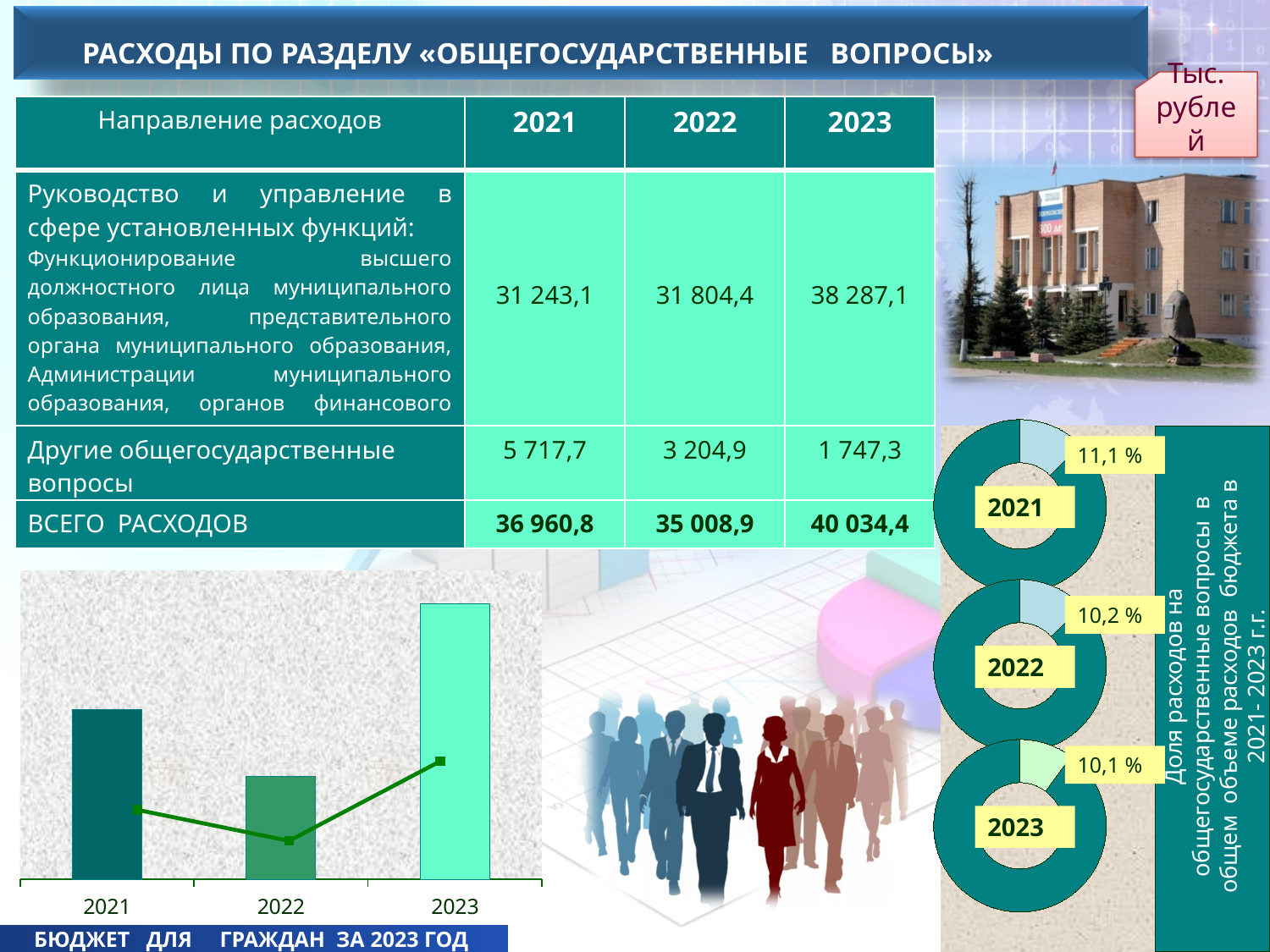
What kind of chart is shown in the bottom-left of the slide? bar chart In the bottom-left bar chart, do the bars rise or fall from 2022 to 2023? rise How many categories are shown on the x axis of the bottom-left bar chart? 3 In the bottom-left bar chart, which year has the shortest bar? 2022 In the bottom-left bar chart, which year has the tallest bar? 2023 In the bottom-left bar chart, is the bar for 2021 taller or shorter than the bar for 2022? taller In the donut charts on the right, what share is shown for 2023? 10,1 % In the donut charts on the right, what is the difference between the share for 2021 and the share for 2022? 0,9 % In the donut charts on the right, what share is shown for 2021? 11,1 % In the donut charts on the right, what share is shown for 2022? 10,2 % Among the donut charts on the right, which year has the highest share? 2021 In the bottom-left bar chart, do the bars rise or fall from 2021 to 2022? fall